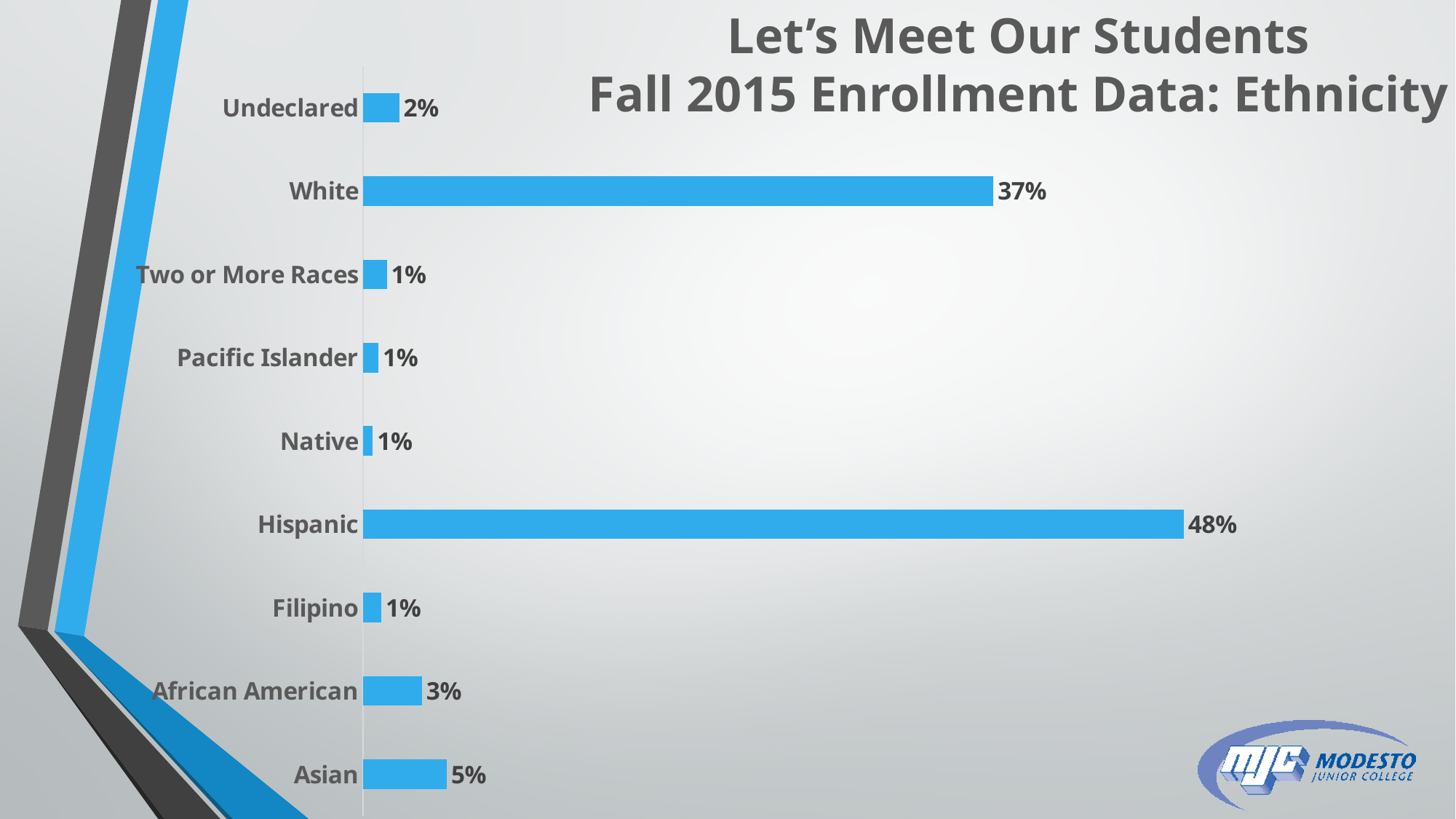
What is the difference between the Asian and African American percentages? 2% Which is larger, the value for Asian or the value for Undeclared? Asian What kind of chart is shown on the slide? Bar chart What is the value for Asian? 5% What is the value for African American? 3% Which ethnicity category has the highest percentage? Hispanic What percentage of students are Hispanic? 48% What is the title of the slide? Let's Meet Our Students Fall 2015 Enrollment Data: Ethnicity What percentage of students are White? 37% What is the difference between the Hispanic and White percentages? 11% What is the value for Undeclared? 2% How many ethnicity categories are shown in the chart? 9